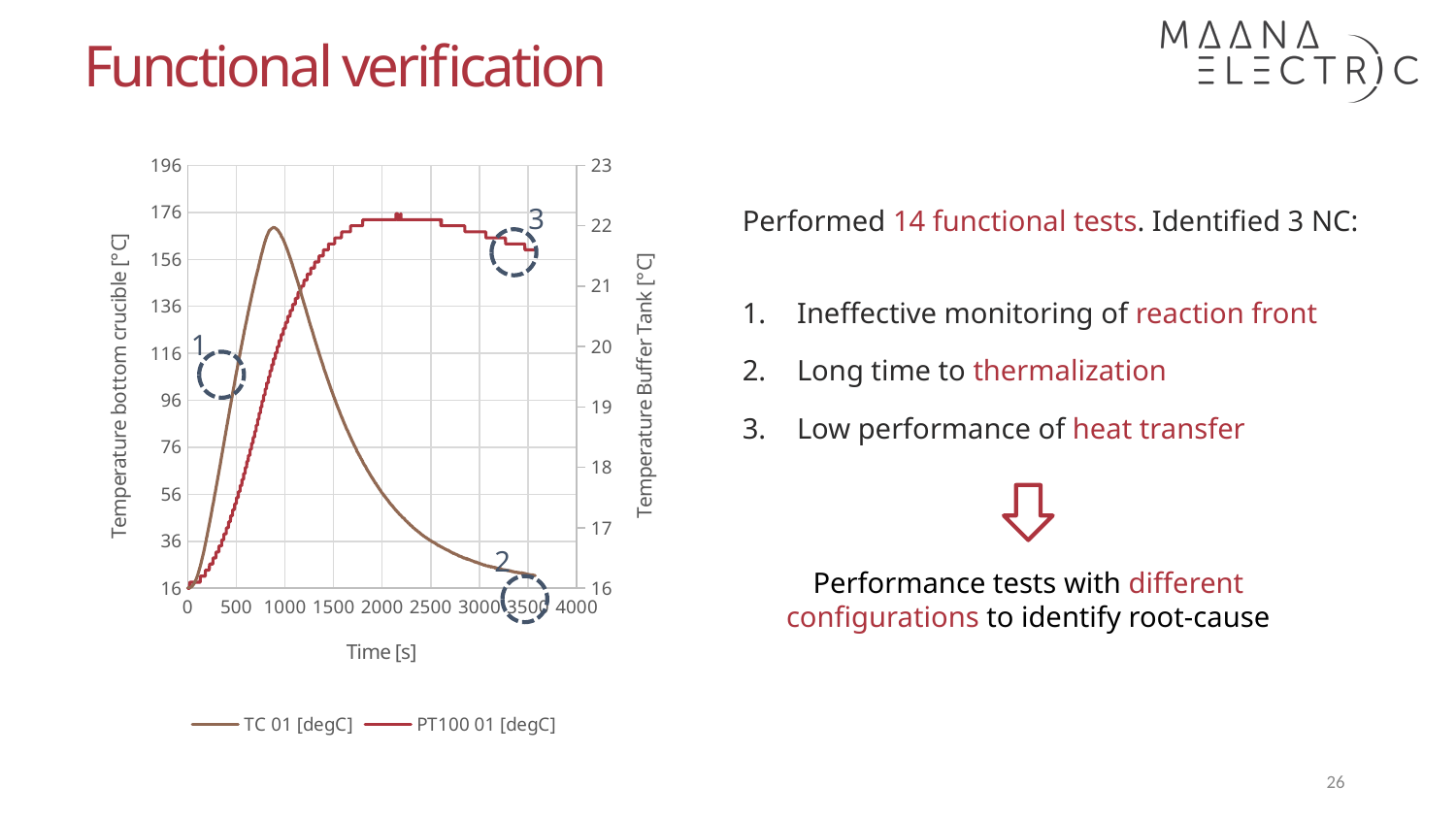
Is the value of PT100 01 at 3500 s greater or less than 21 on the right axis? greater Is the value of TC 01 at 1000 s greater or less than 136 on the left axis? greater How many series does the chart legend list? 2 Is the value of TC 01 at 3000 s greater or less than 56 on the left axis? less Does the TC 01 series rise or fall between 1000 s and 3000 s? fall What kind of chart is shown on the slide? line chart Does the TC 01 series rise or fall between 0 s and 500 s? rise What are the two series named in the chart legend? TC 01 [degC] and PT100 01 [degC] Does the PT100 01 series rise or fall between 0 s and 1500 s? rise What is the label of the x axis of the chart? Time [s]